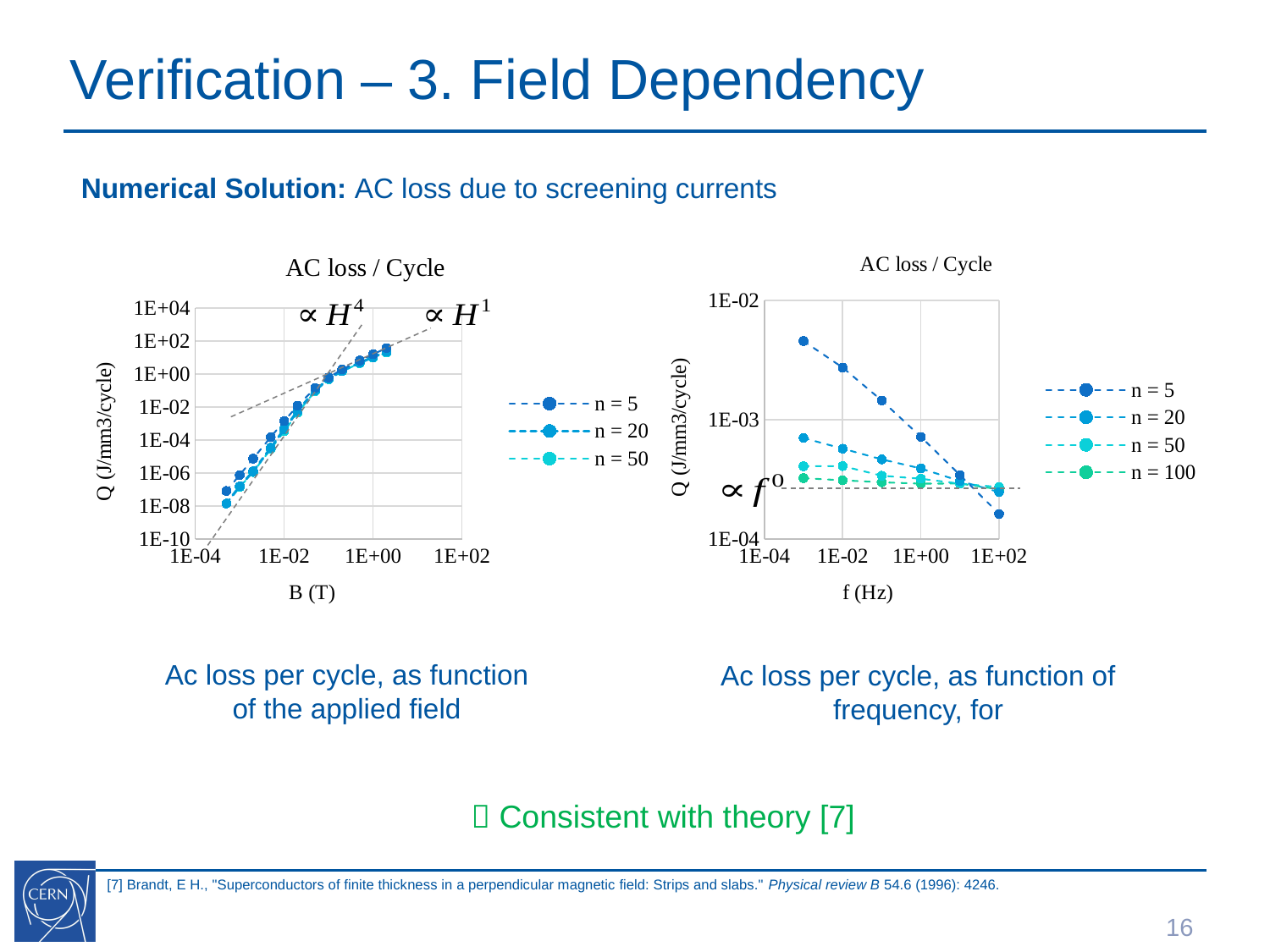
What are the legend entries of the right chart (AC loss per cycle vs. frequency)? n = 5, n = 20, n = 50, n = 100 In the right chart (AC loss per cycle vs. frequency), is the n = 5 value at f = 1E-03 greater or less than 1E-03? greater In the left chart (AC loss per cycle vs. applied field), is the value at B = 1E-03 greater or less than 1E-04? less What is the x-axis label of the left chart (AC loss per cycle vs. applied field)? B (T) What kind of chart is the right chart (AC loss per cycle vs. frequency)? scatter chart In the right chart (AC loss per cycle vs. frequency), at f = 1E-03, which series has the larger value: n = 5 or n = 100? n = 5 How many series does the legend of the right chart (AC loss per cycle vs. frequency) list? 4 In the left chart (AC loss per cycle vs. applied field), do the values rise or fall as B increases? rise How many series does the legend of the left chart (AC loss per cycle vs. applied field) list? 3 In the right chart (AC loss per cycle vs. frequency), is the n = 5 value at f = 1E+02 greater or less than 1E-03? less In the right chart (AC loss per cycle vs. frequency), does the n = 5 series rise or fall as f increases? fall